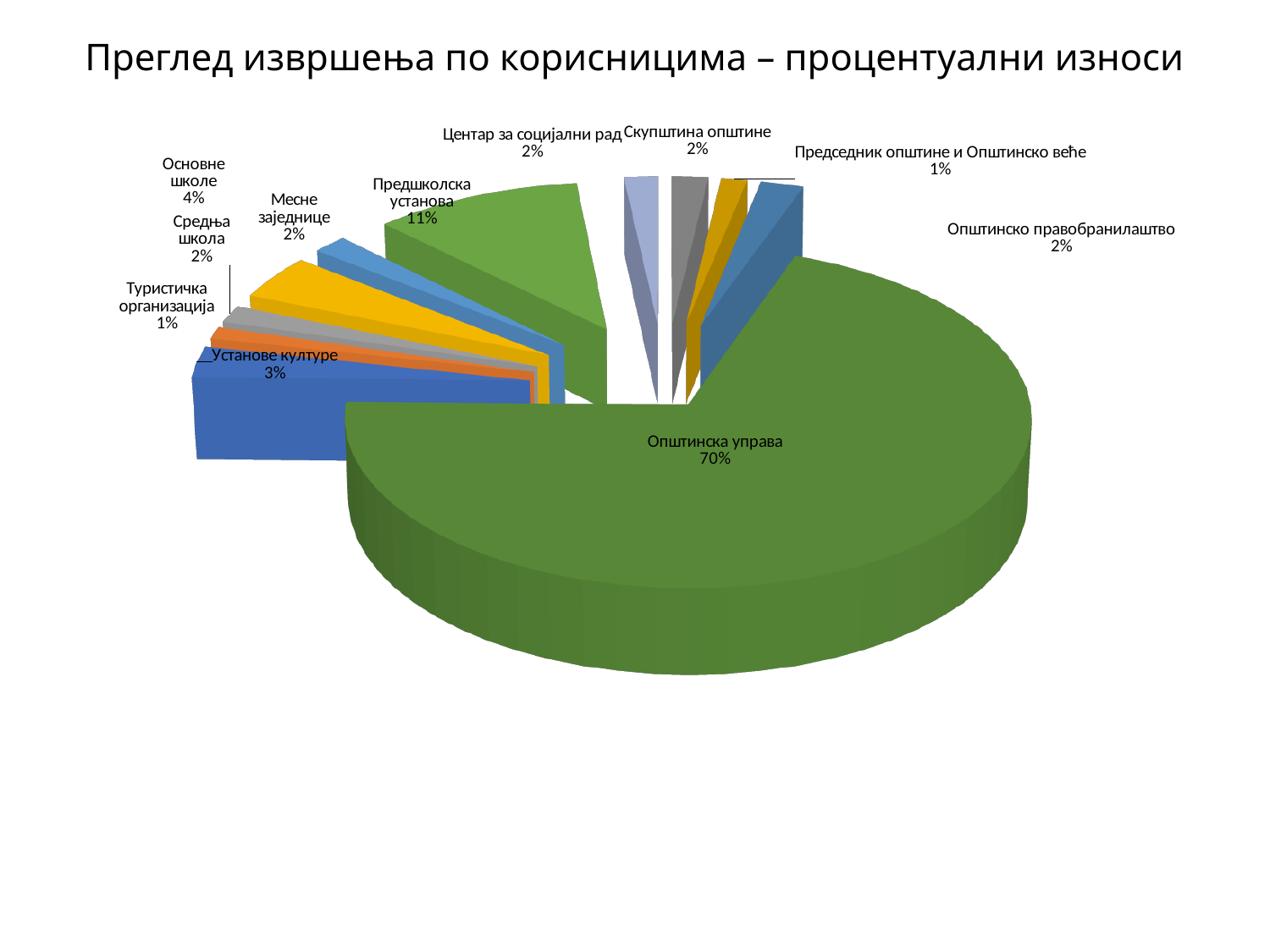
What is the difference between the shares of Предшколска установа and Основне школе? 7% How many categories (slices) are shown in the pie chart? 11 What is the value shown for Туристичка организација? 1% What is the title of the slide? Преглед извршења по корисницима – процентуални износи What kind of chart is shown on the slide? Pie chart What is the value shown for Основне школе? 4% Which is larger, the share for Основне школе or the share for Средња школа? Основне школе Which category has the largest slice of the pie? Општинска управа What is the value shown for Предшколска установа? 11% What is the difference between the shares of Општинска управа and Предшколска установа? 59% What is the value shown for Установе културе? 3% What share of the pie does Општинска управа have? 70%